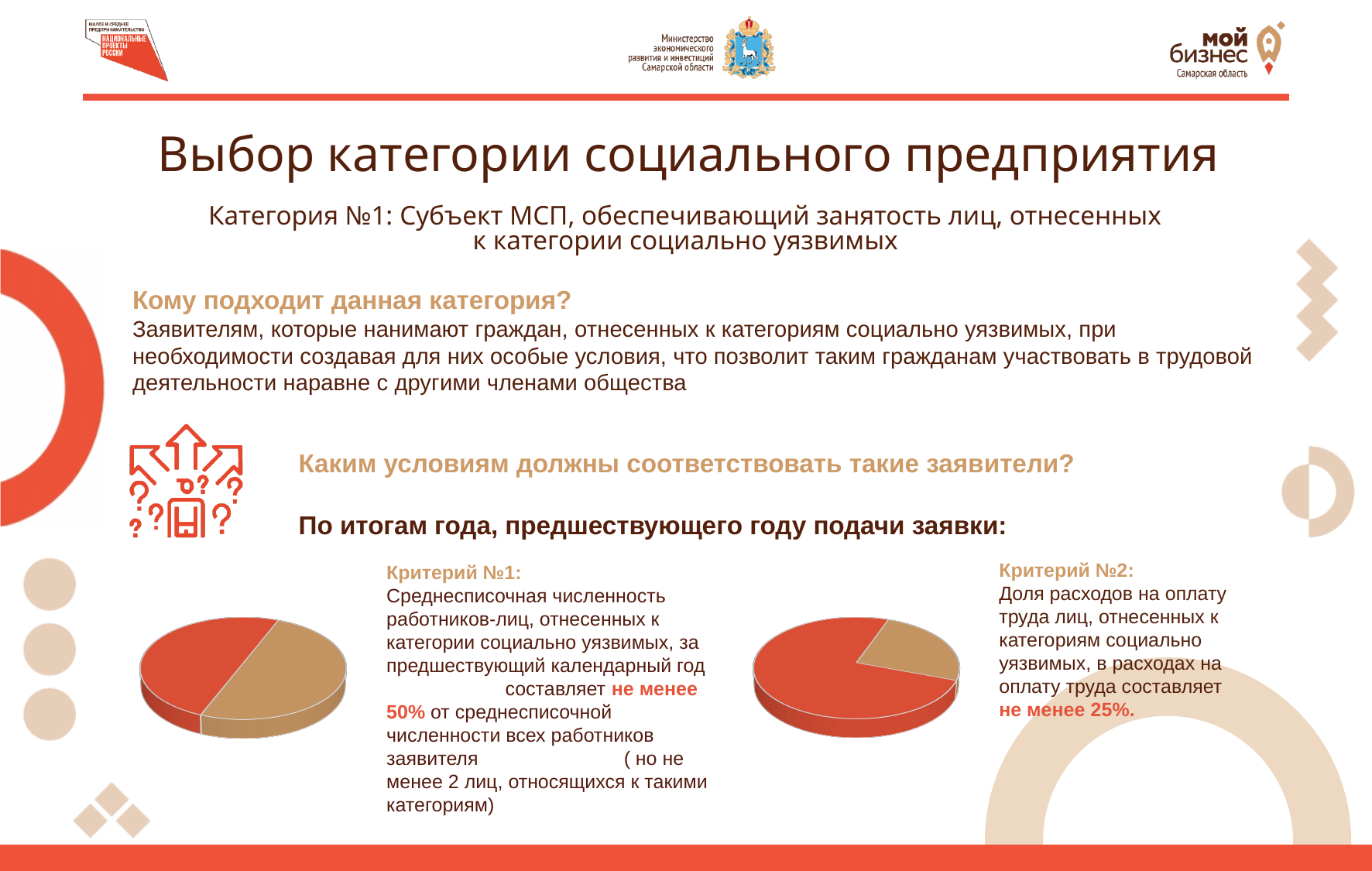
What kind of chart is shown next to Критерий №2 on the right? Pie chart In the right pie chart (next to Критерий №2), does the red slice cover more or less than half of the pie? More What two colours are used for the slices in the pie charts on the slide? Red and tan How many slices does the left pie chart (next to Критерий №1) have? 2 How many slices does the right pie chart (next to Критерий №2) have? 2 In the right pie chart (next to Критерий №2), which slice is larger, the red one or the tan one? The red one How many pie charts are shown on the slide? 2 What kind of chart is shown next to Критерий №1 on the left? Pie chart